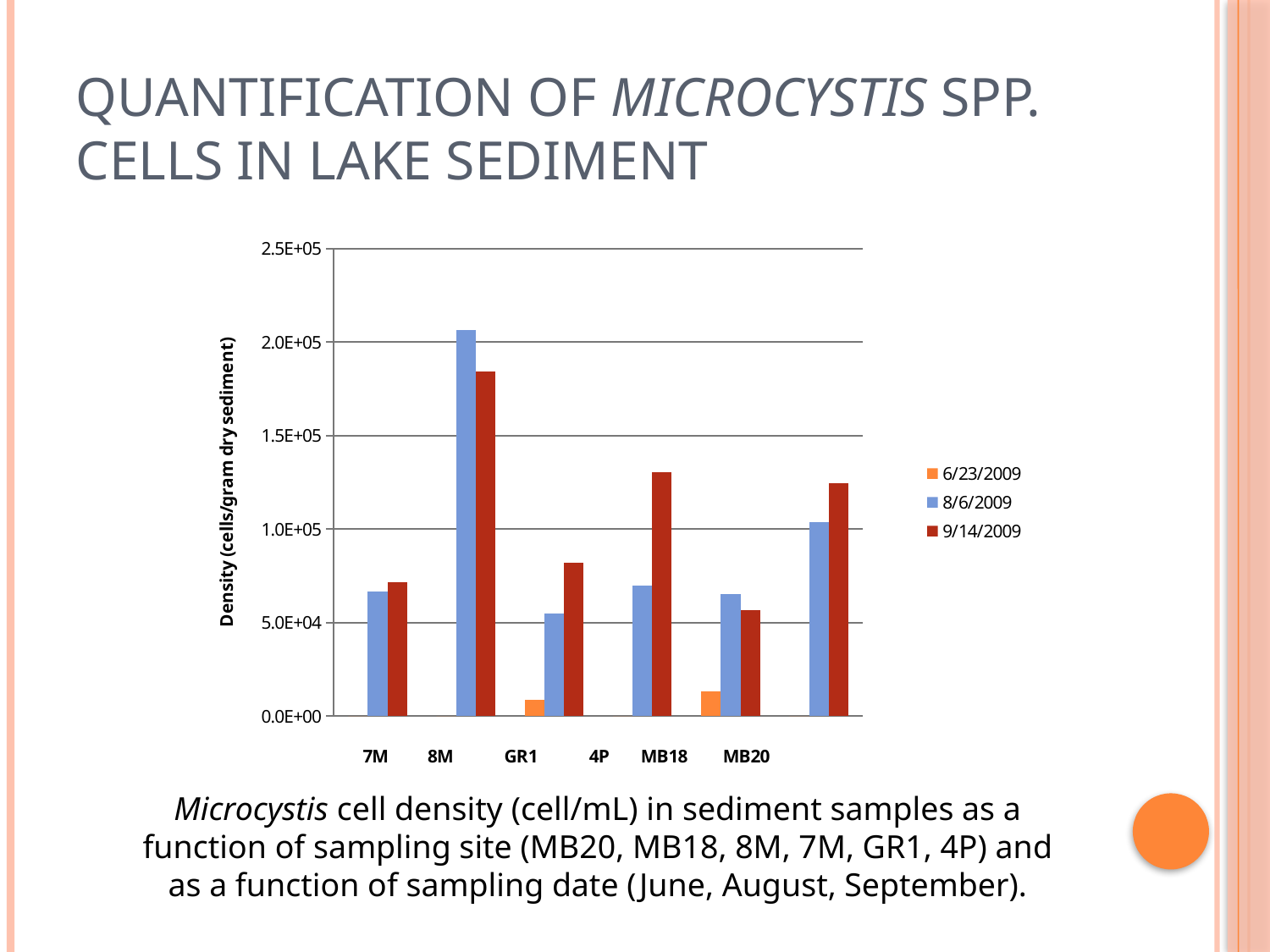
How many sampling sites are shown on the x axis of the chart? 6 Which sampling date is shown in orange in the legend? 6/23/2009 Which sampling date has the single highest bar in the chart? 8/6/2009 Is the 9/14/2009 value for 8M greater or less than 2.0E+05? less How many series does the chart legend list? 3 At site 4P, which is larger: the 8/6/2009 value or the 9/14/2009 value? 9/14/2009 Which sampling site has the tallest bars in the chart? 8M Is the 8/6/2009 value for 8M greater or less than 2.0E+05? greater For how many sampling sites is a 6/23/2009 bar plotted? 2 What is the y-axis title of the chart? Density (cells/gram dry sediment) What kind of chart is shown on the slide? Bar chart